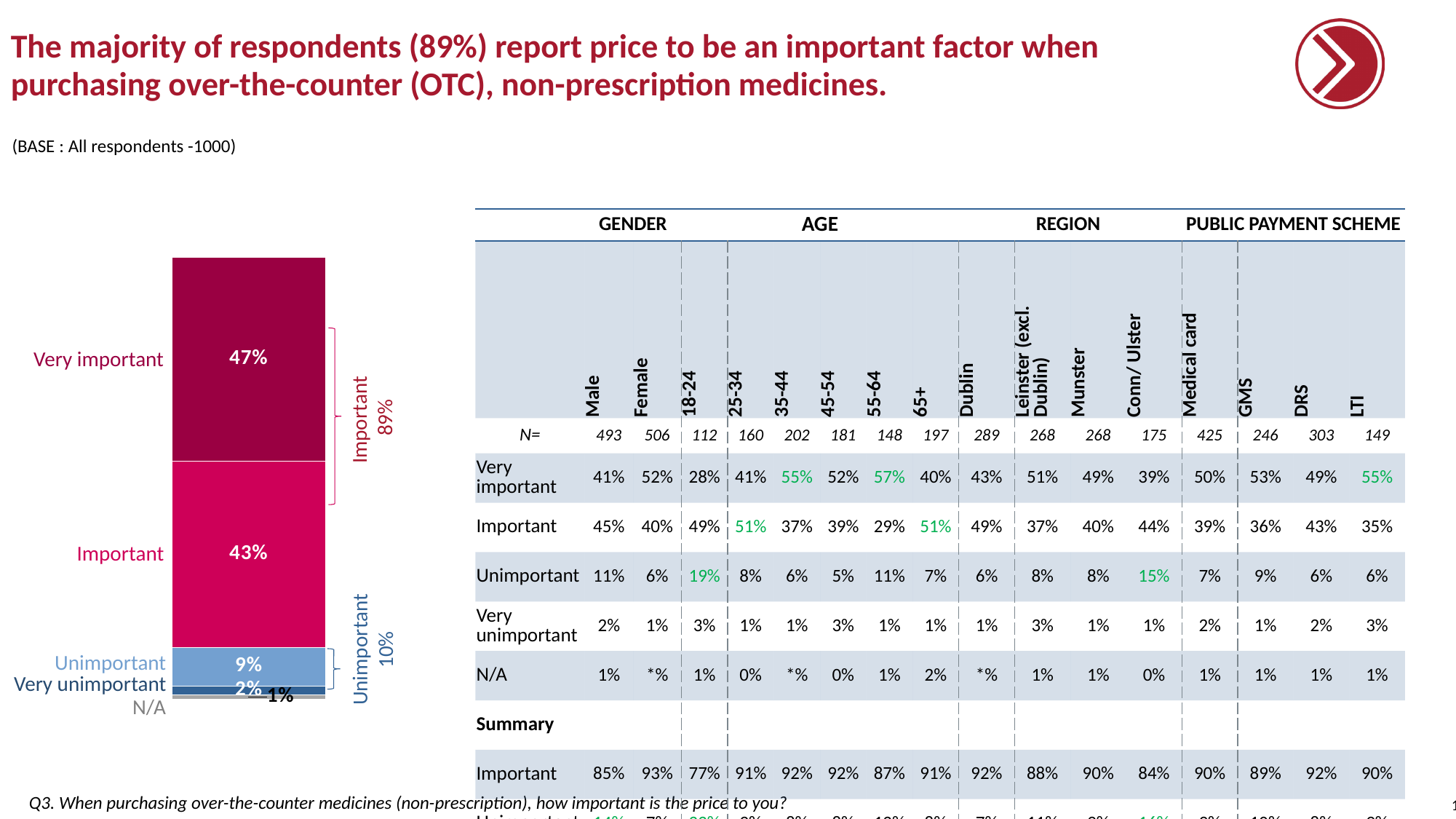
What is the difference between the 'Very important' and 'Important' segments? 4% What percentage of respondents said price is very important when purchasing OTC medicines? 47% Which response category has the largest share in the stacked bar? Very important What type of chart is shown on the left of the slide? Stacked bar chart What percentage of respondents answered N/A? 1% What percentage of respondents said price is important (the 'Important' segment of the bar)? 43% What combined percentage is shown by the bracket labelled 'Important' next to the bar? 89% Which is larger, the 'Unimportant' segment or the 'Very unimportant' segment? Unimportant How many segments make up the stacked bar? 5 What percentage of respondents said price is very unimportant? 2% Which response category has the smallest share in the stacked bar? N/A What percentage of respondents said price is unimportant? 9%